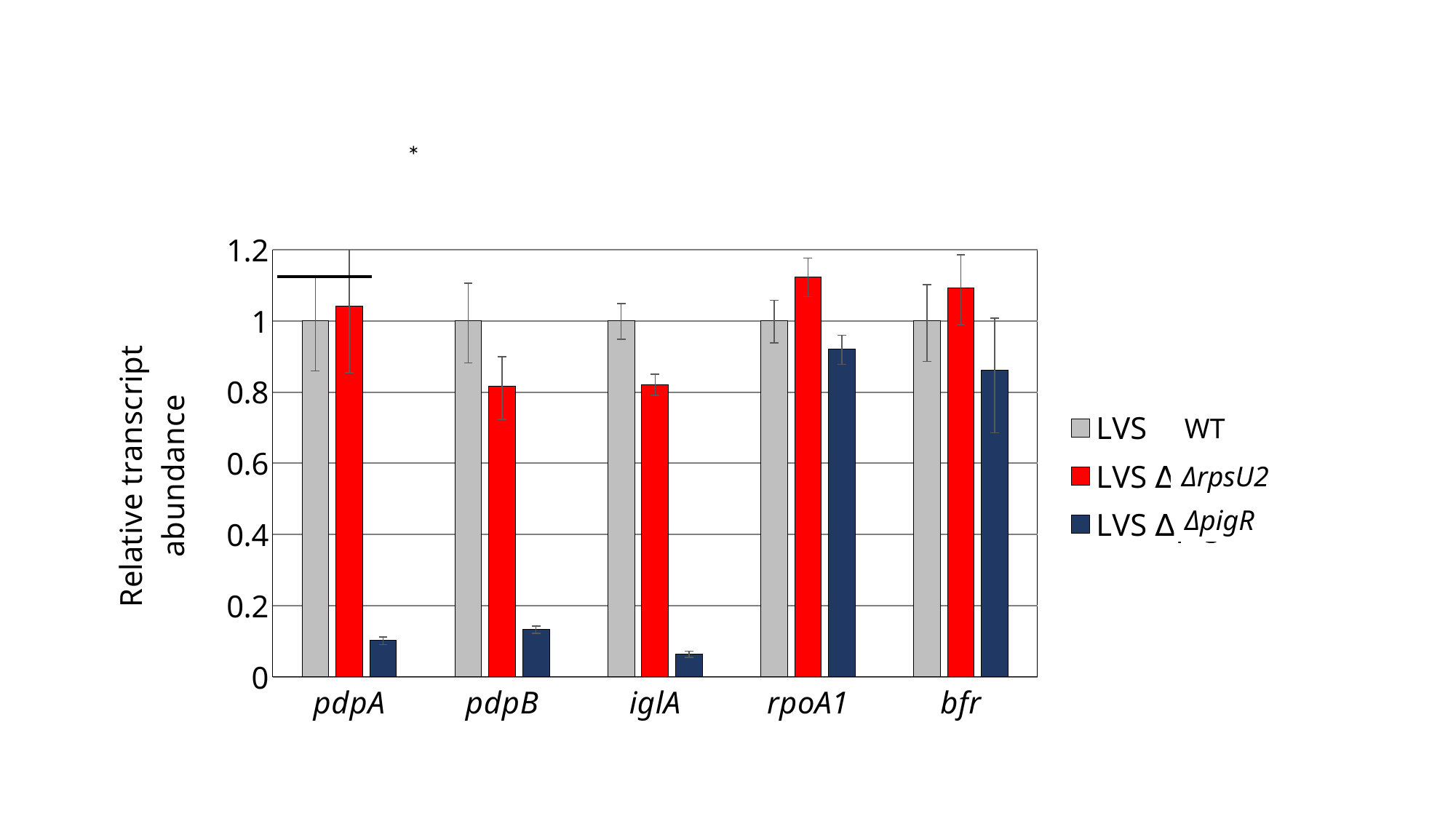
For the LVS ΔpigR series, which is larger: the value for pdpA or the value for rpoA1? rpoA1 How many series does the legend list? 3 Among the LVS ΔpigR bars, which gene has the lowest value? iglA Is the value of the LVS ΔrpsU2 bar for rpoA1 greater or less than 1? greater What is the y-axis label of the chart? Relative transcript abundance Is the value of the LVS ΔpigR bar for iglA greater or less than 0.2? less How many gene categories are shown on the x axis? 5 What is the value of the LVS WT bar for pdpA? 1 For pdpB, which is larger: the LVS ΔrpsU2 bar or the LVS ΔpigR bar? LVS ΔrpsU2 Is the value of the LVS ΔpigR bar for pdpA greater or less than 0.2? less What kind of chart is shown on the slide? bar chart